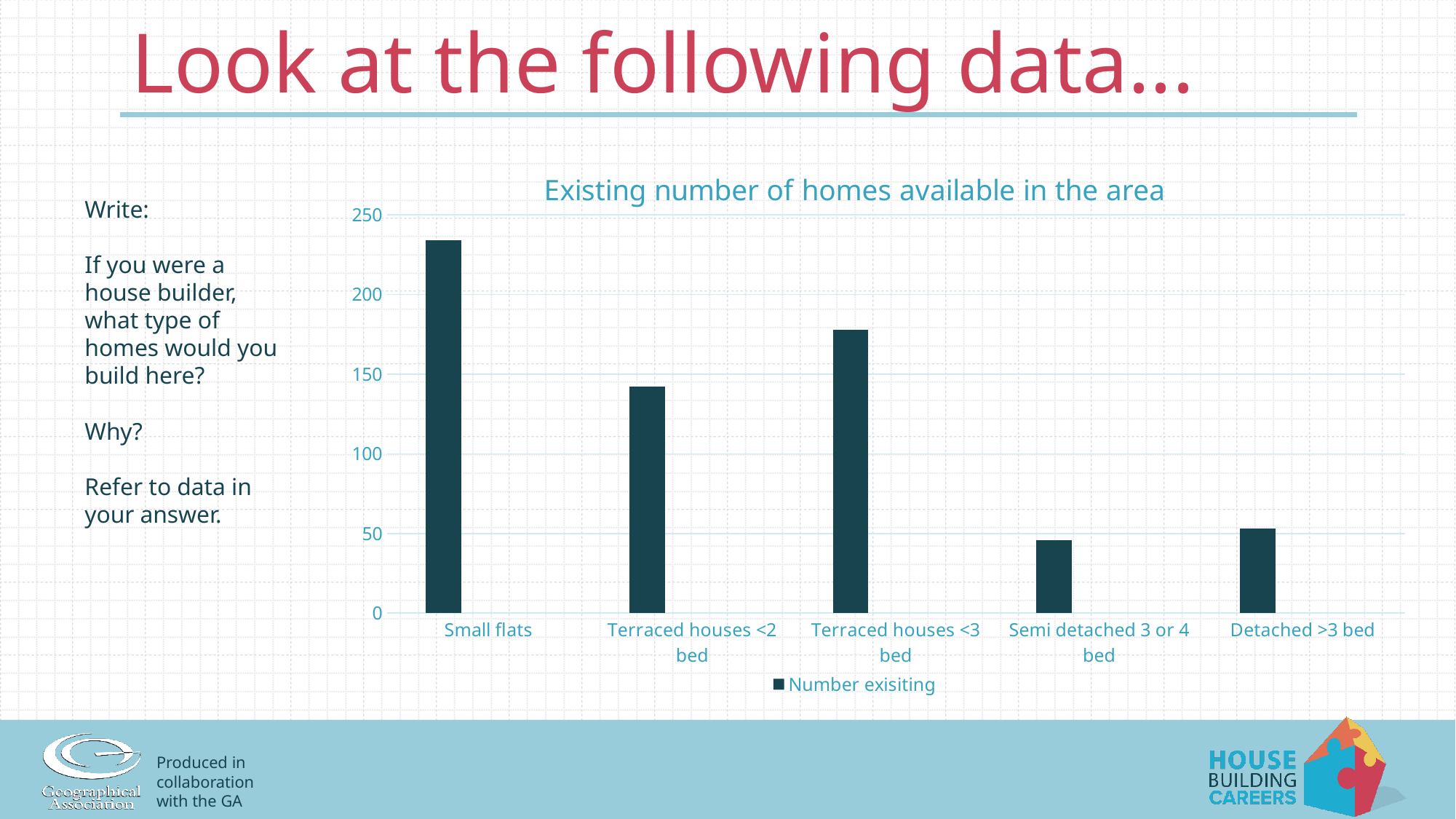
What is the title of the chart? Existing number of homes available in the area How many categories of homes are shown on the x axis? 5 Which has more existing homes, Terraced houses <2 bed or Terraced houses <3 bed? Terraced houses <3 bed Is the value for Terraced houses <3 bed greater or less than 150? greater Which category has the lowest number of existing homes? Semi detached 3 or 4 bed What is the name of the series shown in the legend? Number exisiting How many series does the legend list? 1 Is the value for Terraced houses <2 bed greater or less than 150? less Is the value for Small flats greater or less than 200? greater What type of chart is shown on the slide? bar chart Which category has the highest number of existing homes? Small flats